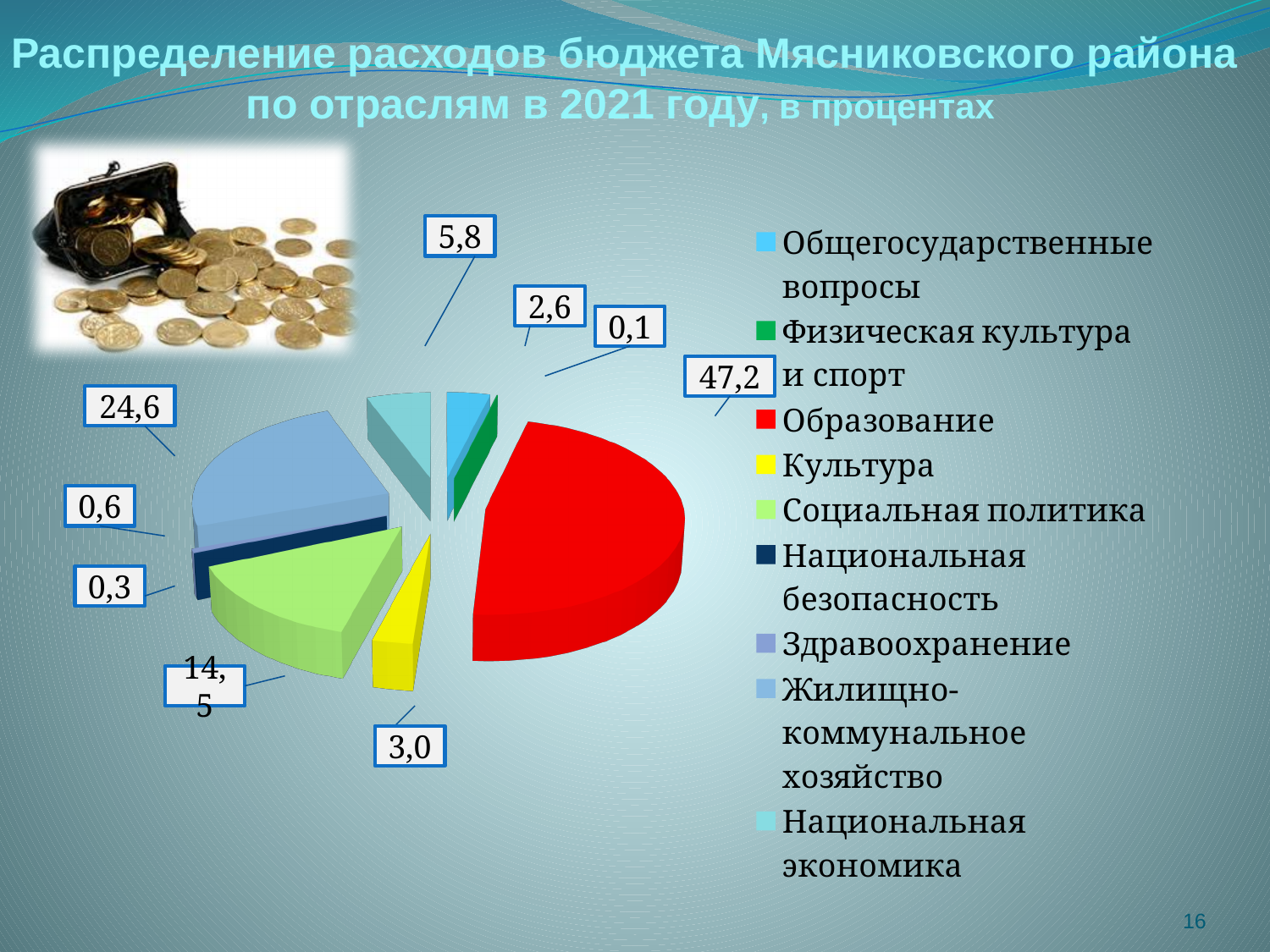
What share of the budget expenditure goes to Жилищно-коммунальное хозяйство? 24,6 What share of the budget expenditure goes to Социальная политика? 14,5 What colour is the slice for Образование? red What share of the budget expenditure goes to Национальная экономика? 5,8 Which has a larger share: Социальная политика or Культура? Социальная политика What share of the budget expenditure goes to Образование? 47,2 What kind of chart is shown on the slide? pie chart Which sector has the largest share of the budget expenditure? Образование How many sectors are listed in the legend of the pie chart? 9 What is the difference between the shares for Образование and Жилищно-коммунальное хозяйство? 22,6 What year does the chart title refer to? 2021 What share of the budget expenditure goes to Культура? 3,0